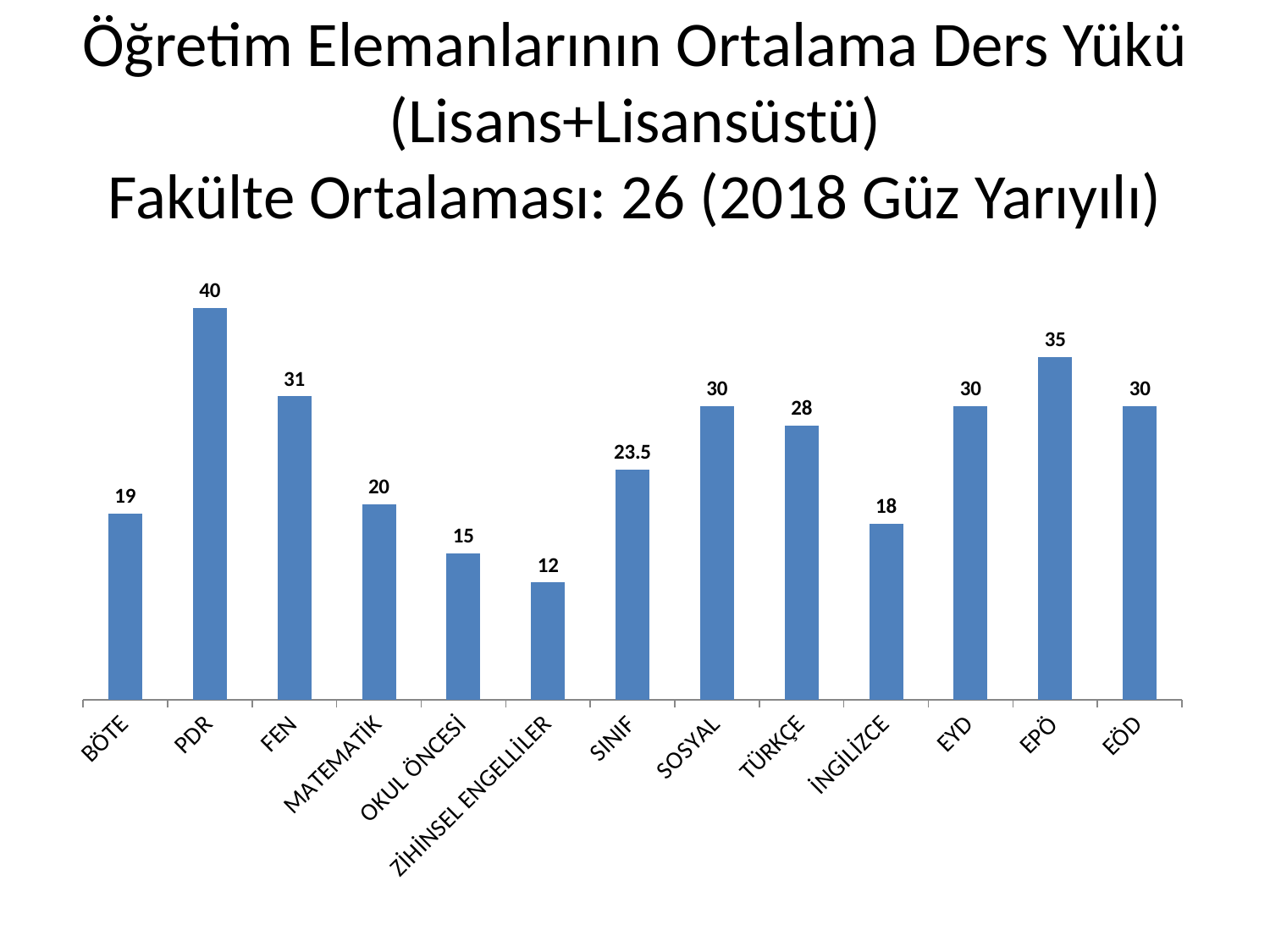
What is the difference between the values for PDR and FEN? 9 What is the value for EPÖ? 35 How many categories are shown on the x axis? 13 What is the value for SINIF? 23.5 Which category has the highest value? PDR Which category has the lowest value? ZİHİNSEL ENGELLİLER What faculty average is stated in the slide title? 26 What is the difference between the values for TÜRKÇE and İNGİLİZCE? 10 What is the value for ZİHİNSEL ENGELLİLER? 12 What kind of chart is shown on the slide? bar chart Which is larger, the value for MATEMATİK or the value for OKUL ÖNCESİ? MATEMATİK What is the value for PDR? 40